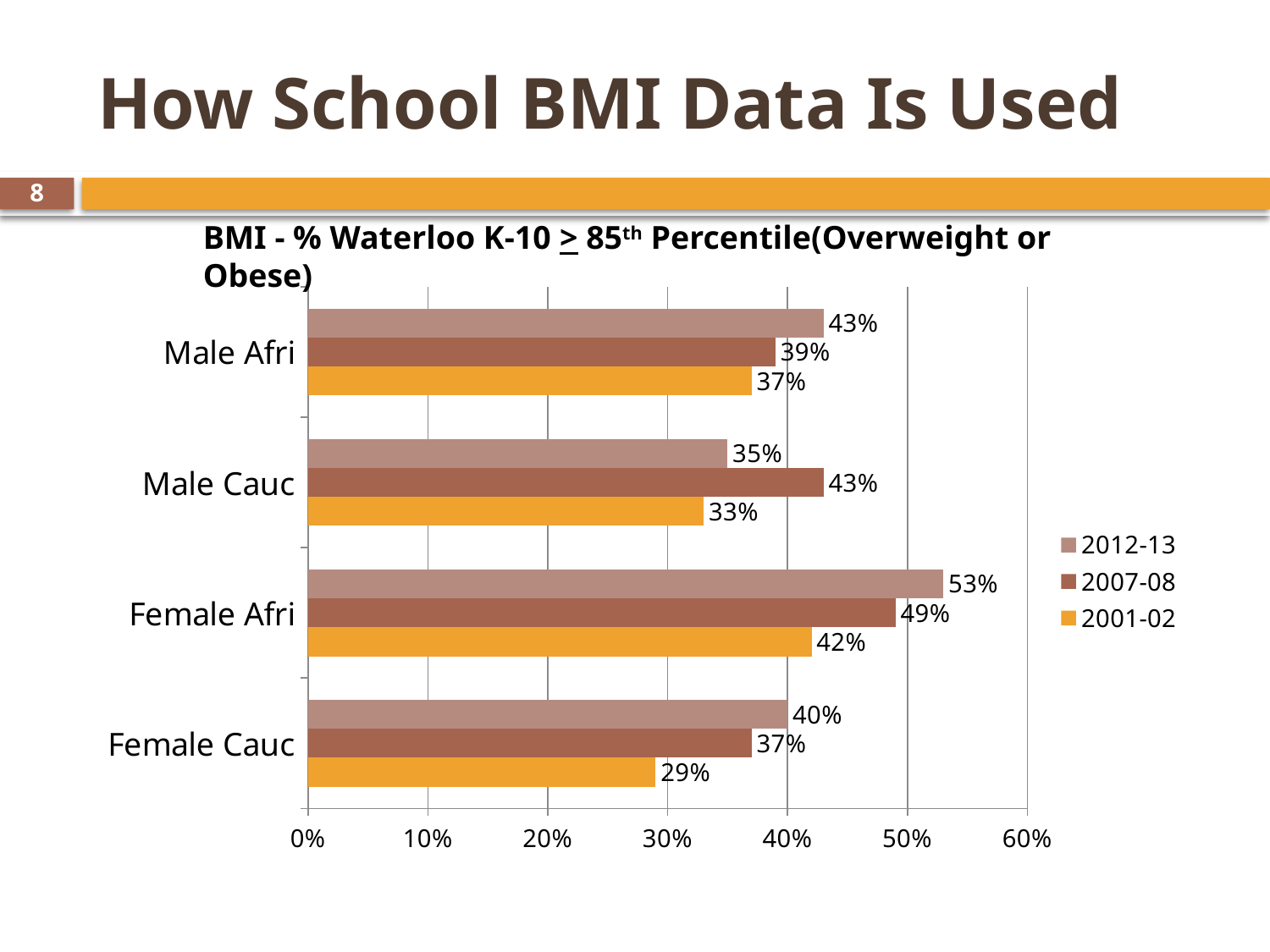
What is the value for Female Cauc in the 2007-08 series? 37% What is the value for Female Afri in the 2012-13 series? 53% Which category has the lowest value in the 2012-13 series? Male Cauc Which series is shown in yellow-orange in the legend? 2001-02 Is the value for Female Afri in 2007-08 greater or less than 40%? greater What kind of chart is shown on the slide? bar chart Which category has the highest value in the 2001-02 series? Female Afri What is the difference between the 2012-13 and 2001-02 values for Female Cauc? 11% Which is larger for Male Cauc: the 2007-08 value or the 2012-13 value? 2007-08 What is the value for Male Cauc in the 2001-02 series? 33% How many categories are shown on the chart? 4 How many series does the legend list? 3